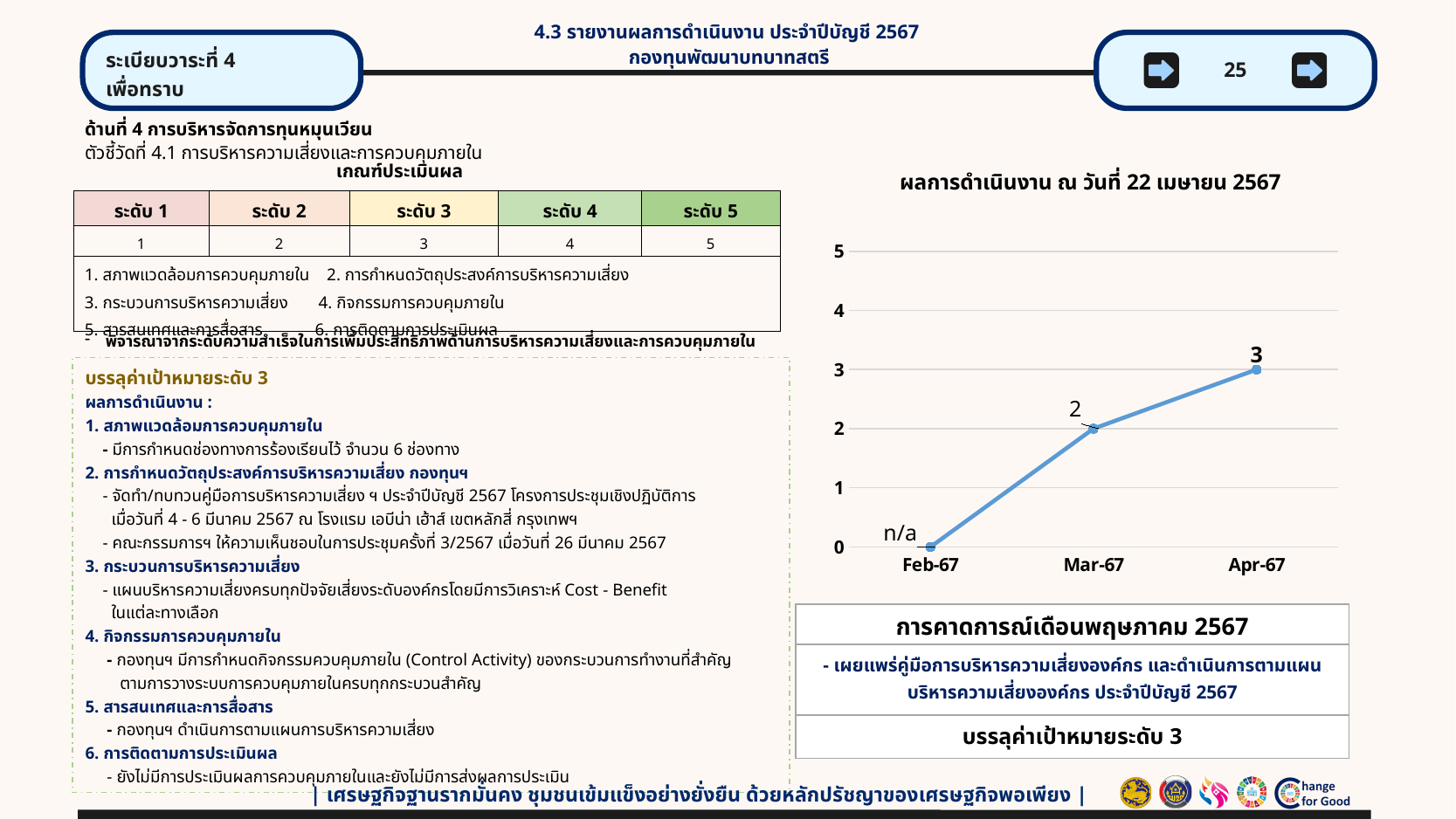
How many months are plotted on the x axis of the chart? 3 What is the title of the chart? ผลการดำเนินงาน ณ วันที่ 22 เมษายน 2567 What is the value for Mar-67 in the chart? 2 What is the value for Apr-67 in the chart? 3 Do the values rise or fall from Feb-67 to Apr-67? rise What type of chart is shown on the slide? line chart What data label is shown for Feb-67 in the chart? n/a Which month has the highest value in the chart? Apr-67 What is the difference between the values for Apr-67 and Mar-67? 1 Which is larger, the value for Mar-67 or the value for Apr-67? Apr-67 Which month has the lowest value in the chart? Feb-67 Is the value for Apr-67 greater or less than 4? less